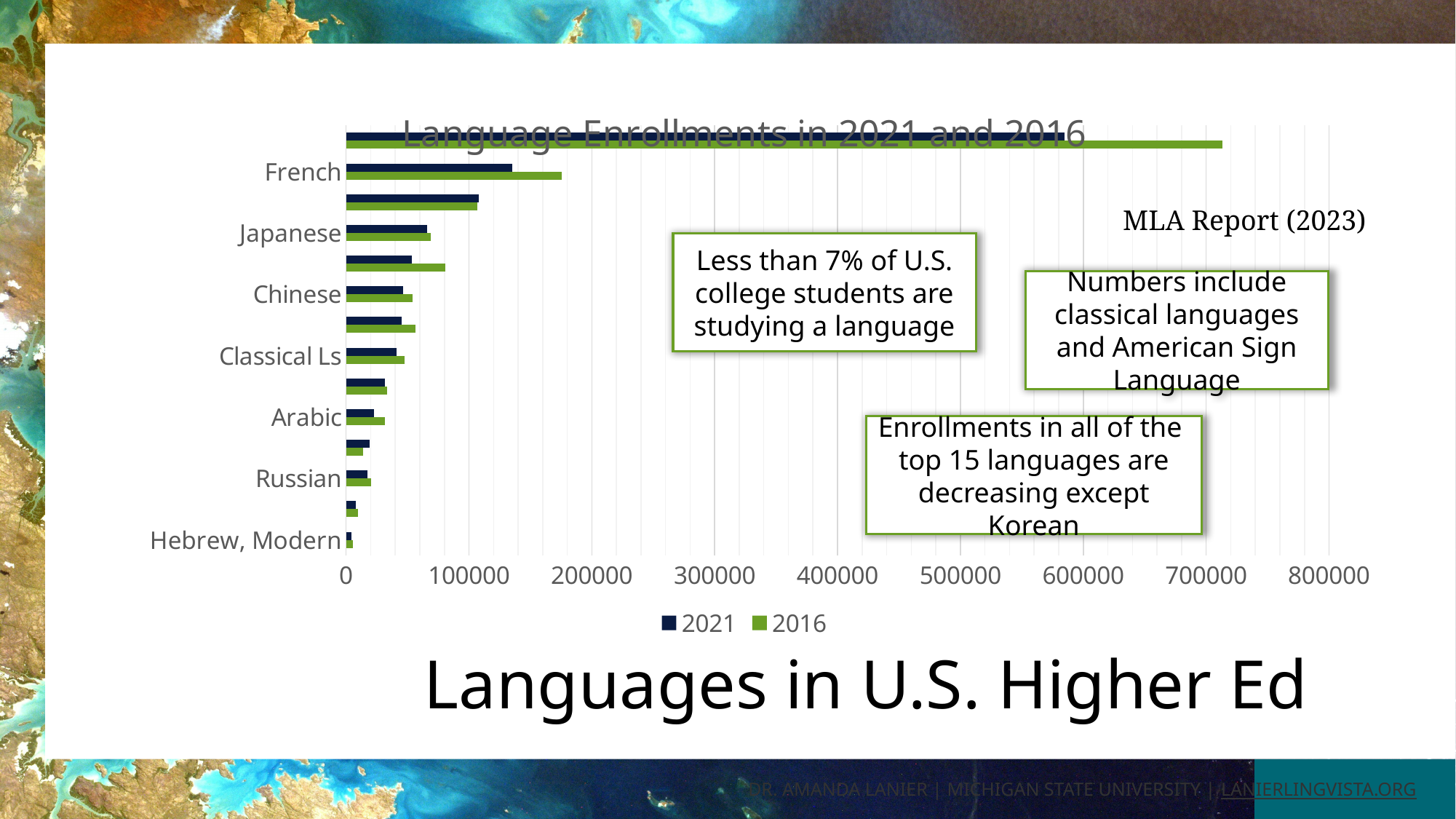
For French, which series has the larger value, 2021 or 2016? 2016 What kind of chart is shown on the slide? bar chart Is the 2016 value for Arabic greater or less than 100000? less What is the title of the chart? Language Enrollments in 2021 and 2016 Among the labeled languages, which has the lowest 2021 value? Hebrew, Modern Which has the larger 2021 value, French or Japanese? French How many series does the legend of the chart list? 2 Which series is drawn in green in the chart? 2016 Is the 2016 value for French greater or less than 200000? less Which has the larger 2016 value, Japanese or Chinese? Japanese Is the 2021 value for Japanese greater or less than 100000? less